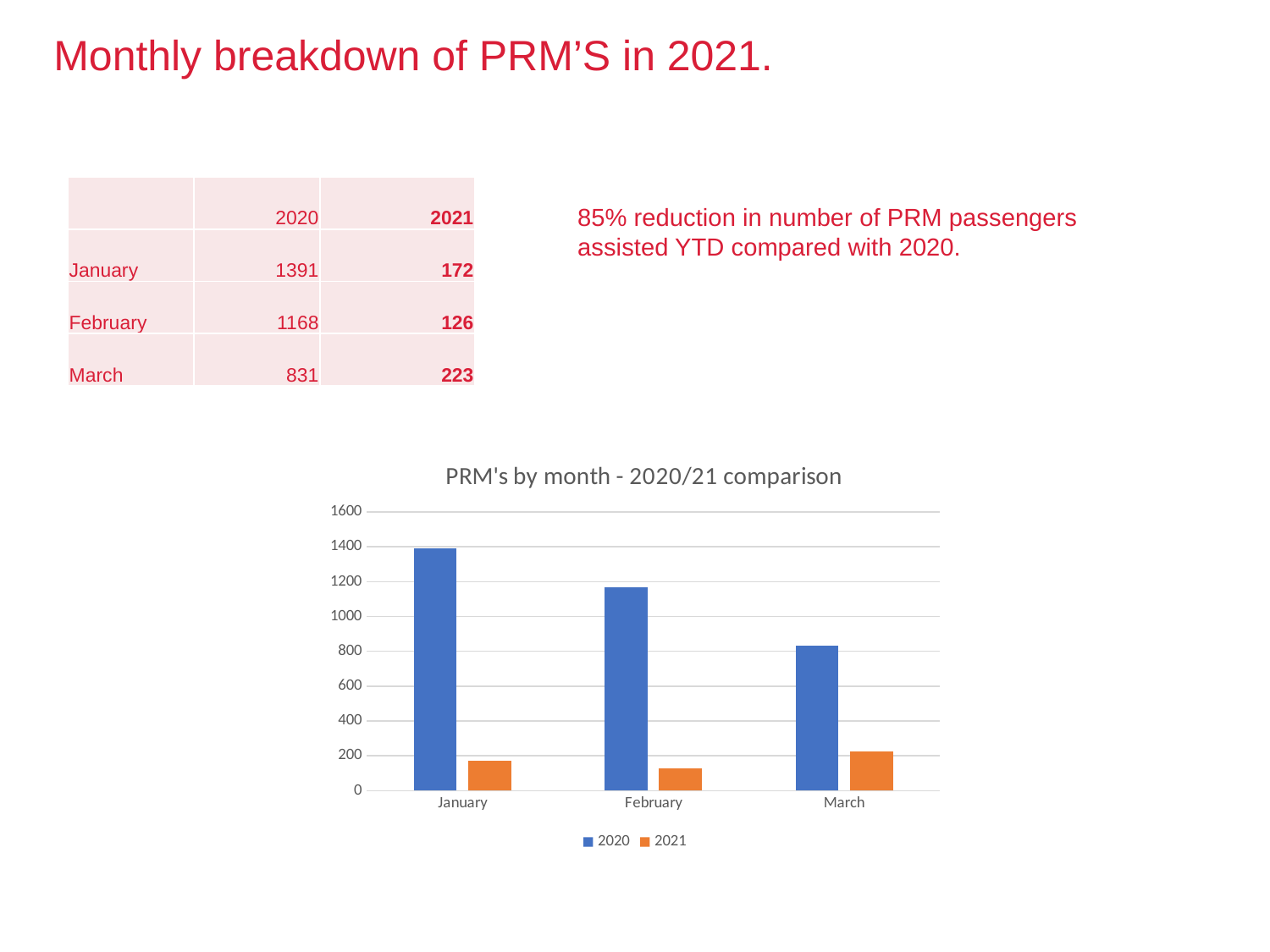
Is the 2021 value for March greater or less than 200? greater What type of chart is shown on the slide? bar chart How many months are shown on the x axis of the chart? 3 What is the 2020 value for January, as printed in the table on the slide? 1391 Is the 2020 value for March greater or less than 1000? less Which month has the highest value for the 2020 series? January How many series does the chart legend list? 2 Which is larger, the 2020 value for February or the 2020 value for March? 2020 value for February What is the title of the chart? PRM's by month - 2020/21 comparison Which month has the lowest value for the 2021 series? February Do the 2020 values rise or fall from January to March? fall Which month has the highest value for the 2021 series? March